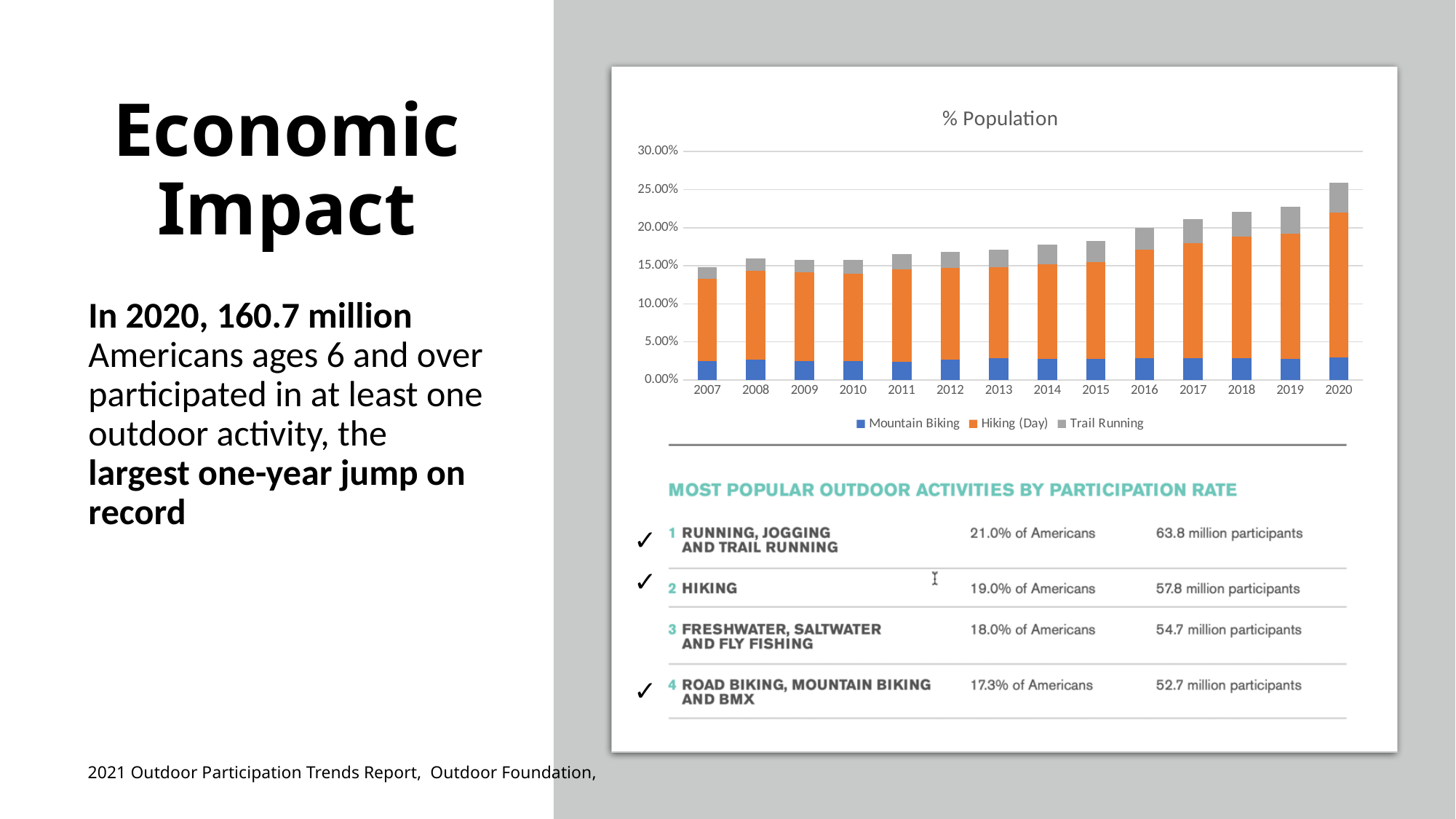
What is the title of the chart? % Population What kind of chart is shown on the slide? stacked bar chart How many series does the chart's legend list? 3 Which series are listed in the chart's legend? Mountain Biking, Hiking (Day), Trail Running Is the total stacked bar for 2016 greater or less than 15.00%? greater Which year has the lowest total stacked bar in the chart? 2007 Is the total stacked bar for 2020 greater or less than 25.00%? greater Is the Mountain Biking value for 2020 greater or less than 5.00%? less Do the total stacked bar values generally rise or fall from 2007 to 2020? rise How many years are shown along the x axis of the chart? 14 Which year has the larger total stacked bar, 2007 or 2020? 2020 Which year has the highest total stacked bar in the chart? 2020